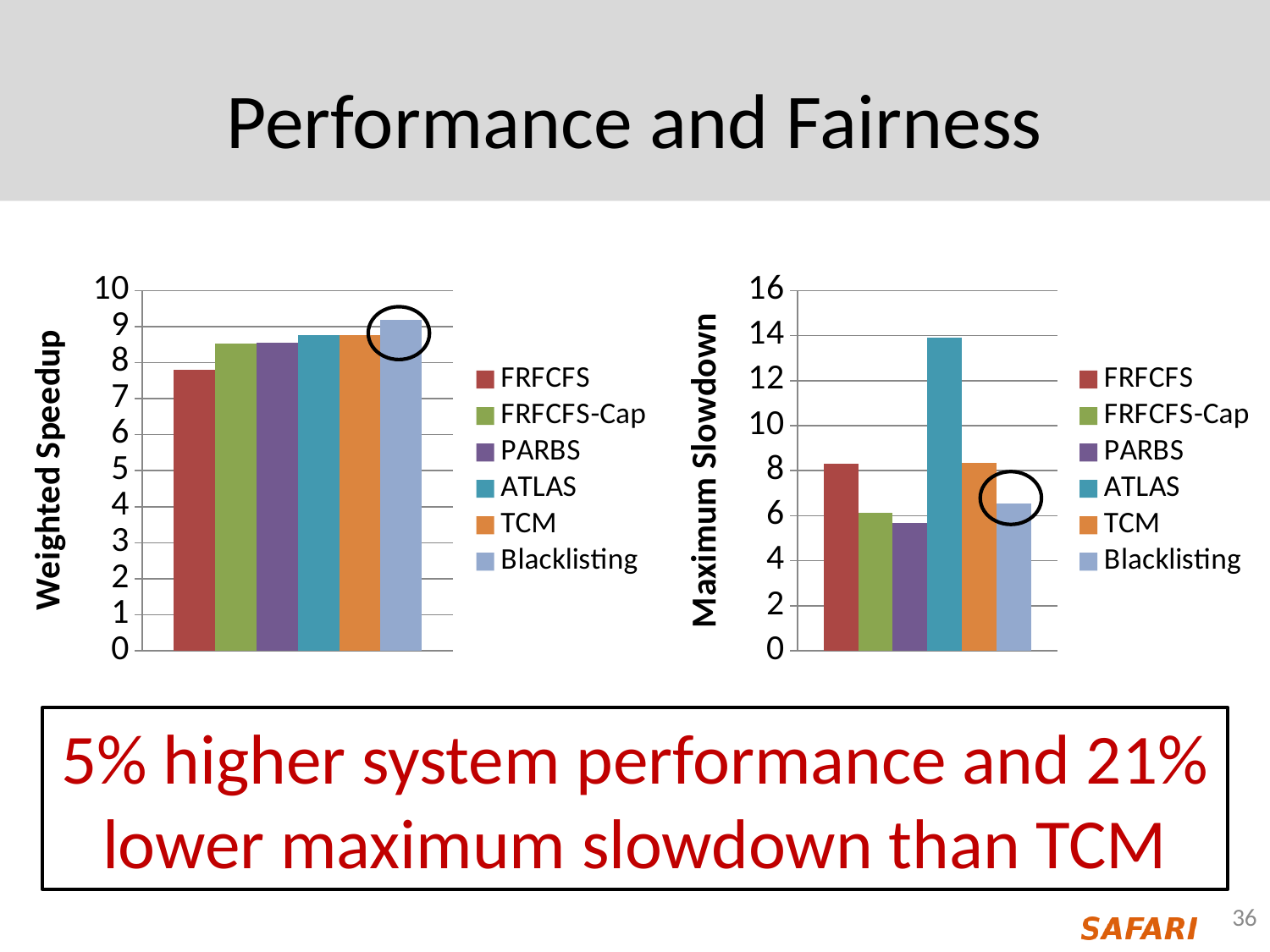
What kind of chart is the Weighted Speedup chart on the left? bar chart In the Weighted Speedup chart on the left, which series has the highest value? Blacklisting What is the y-axis title of the chart on the right? Maximum Slowdown In the Maximum Slowdown chart on the right, is the value for Blacklisting greater or less than 8? less In the Maximum Slowdown chart on the right, is the value for ATLAS greater or less than 12? greater In the Maximum Slowdown chart on the right, which series has the highest value? ATLAS How many series does the legend of the Maximum Slowdown chart on the right list? 6 In the Weighted Speedup chart on the left, which is larger, the value for Blacklisting or the value for FRFCFS? Blacklisting In the Maximum Slowdown chart on the right, which is larger, the value for ATLAS or the value for TCM? ATLAS In the Weighted Speedup chart on the left, is the value for FRFCFS greater or less than 8? less In the Weighted Speedup chart on the left, which series has the lowest value? FRFCFS